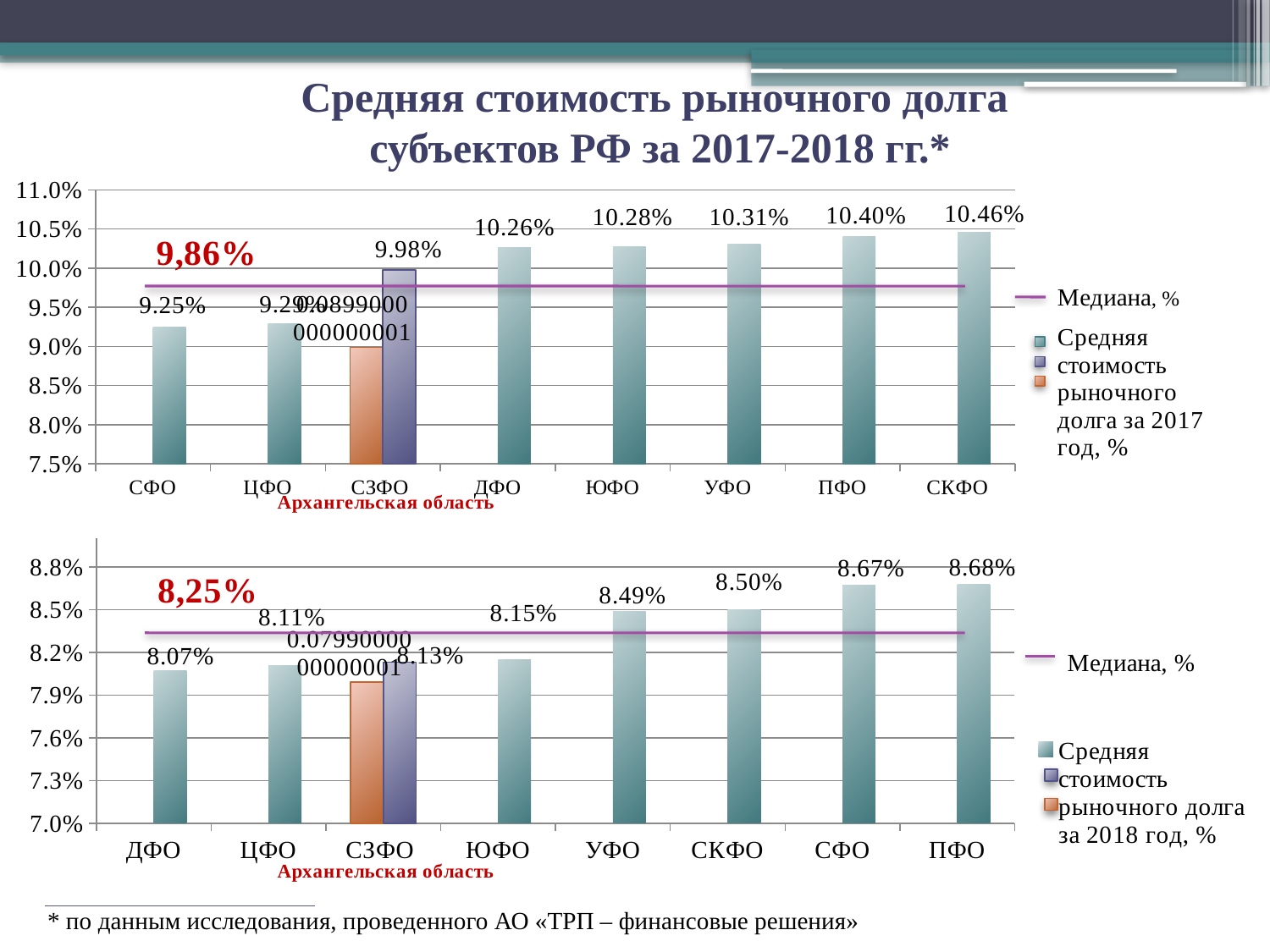
In the bottom chart (2018), which is larger, the value for ЮФО or the value for СКФО? СКФО In the top chart (2017), is the value for ЦФО greater or less than 9.5%? less In the top chart (2017), what is the average cost of market debt for СКФО? 10.46% In the top chart (2017), what is the value shown for ДФО? 10.26% In the bottom chart (2018), what is the value shown for УФО? 8.49% How many federal districts are shown on the x axis of the bottom chart (2018)? 8 In the top chart (2017), what is the median value shown? 9,86% What type of chart is the top chart (2017)? bar chart In the top chart (2017), what is the difference between the values for СКФО and СФО? 1.21% In the bottom chart (2018), which federal district has the highest value? ПФО In the bottom chart (2018), what is the median value shown? 8,25% In the top chart (2017), which federal district has the lowest value? СФО